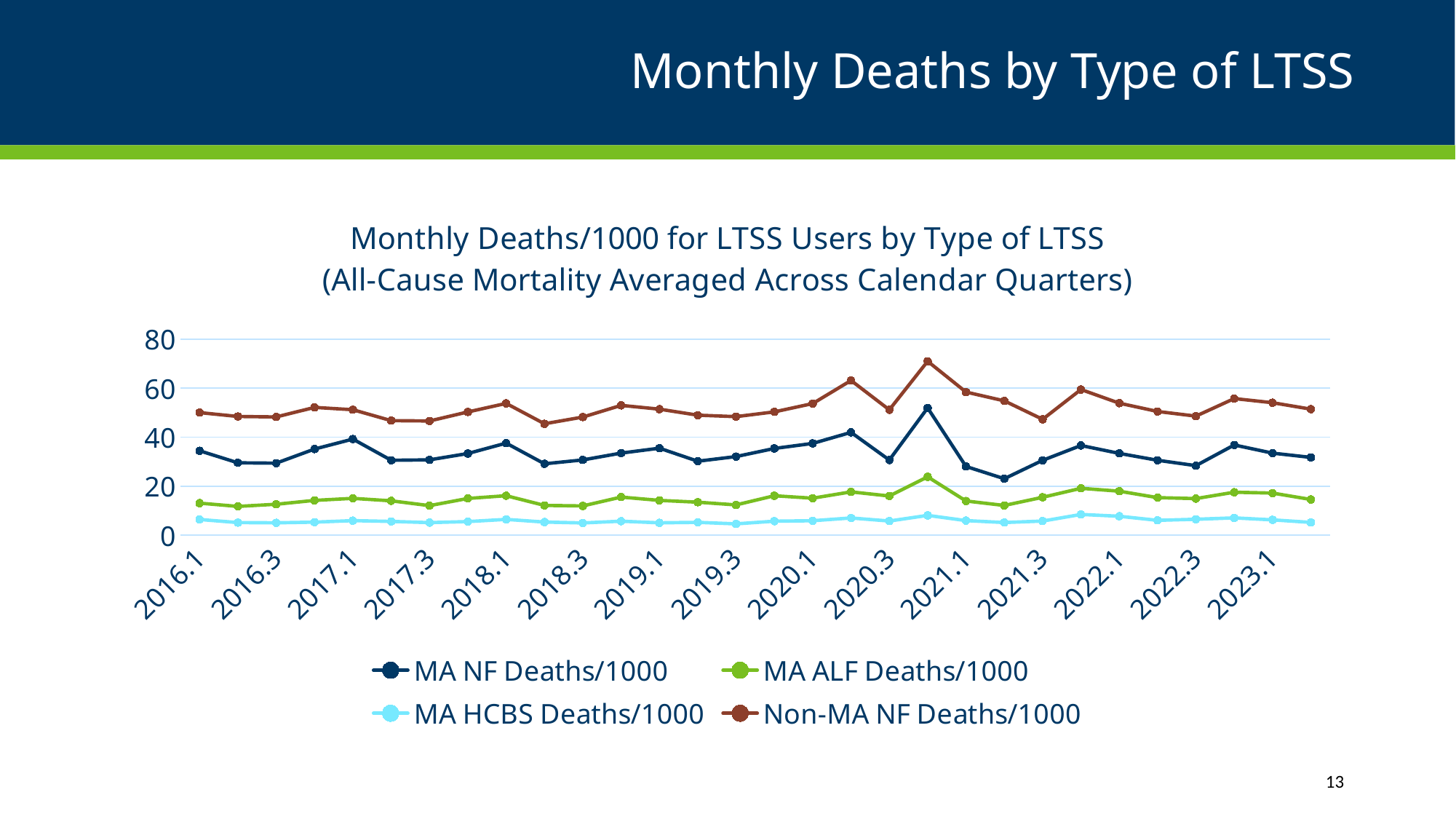
At 2020.1, which is larger: MA NF Deaths/1000 or Non-MA NF Deaths/1000? Non-MA NF Deaths/1000 What is the first line of the chart title? Monthly Deaths/1000 for LTSS Users by Type of LTSS Is the value for MA ALF Deaths/1000 at 2021.1 greater or less than 20? less Which series has the highest values throughout the chart? Non-MA NF Deaths/1000 Is the value for MA NF Deaths/1000 at 2016.1 greater or less than 40? less Is the value for MA HCBS Deaths/1000 at 2023.1 greater or less than 20? less What kind of chart is shown on the slide? line chart Which series has the lowest values throughout the chart? MA HCBS Deaths/1000 How many x-axis labels are shown on the chart? 15 How many series does the legend list? 4